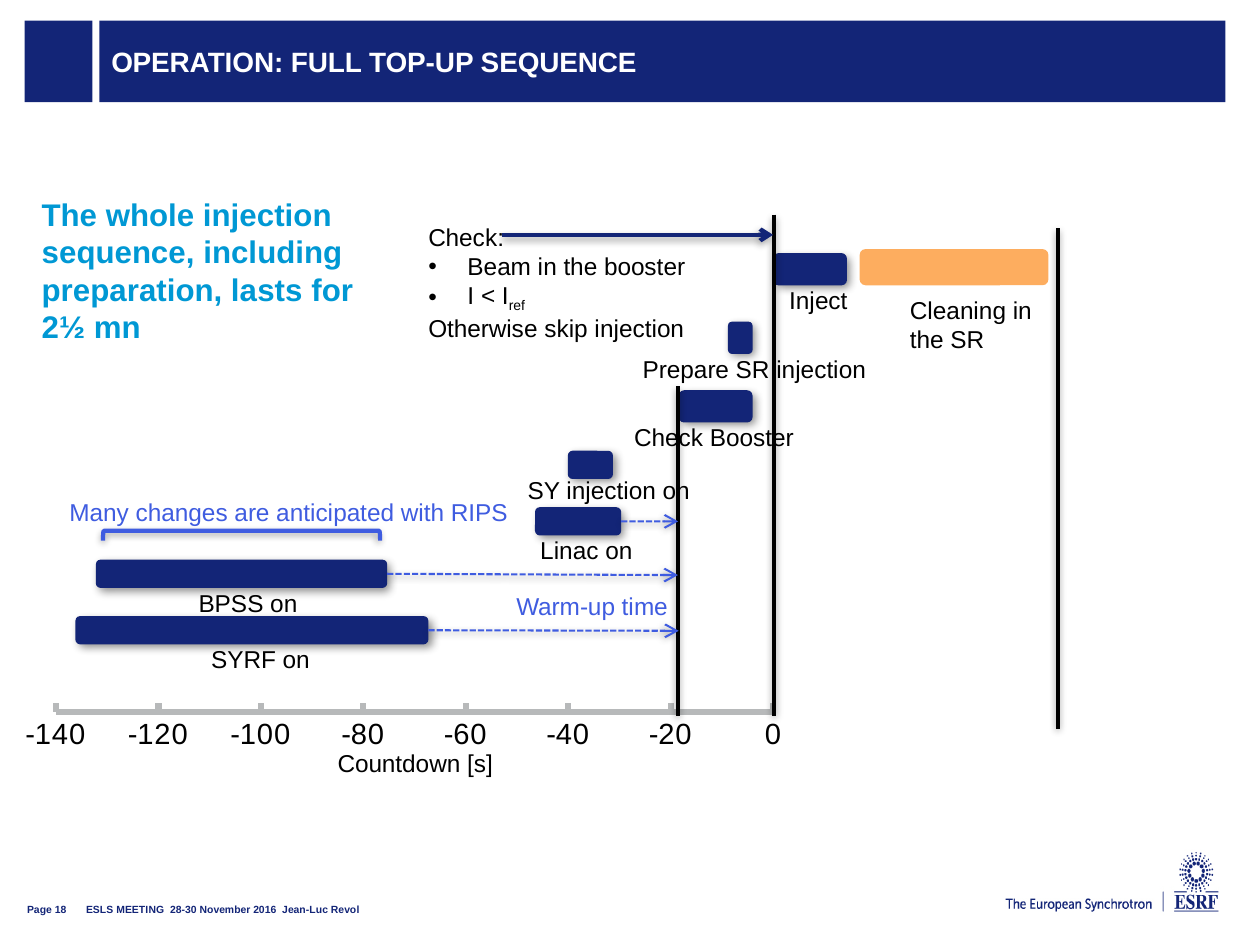
Which bar on the chart is the longest? SYRF on Which bar on the chart is the shortest? Prepare SR injection What kind of chart is shown on the slide? bar chart Which bar on the chart is coloured orange rather than dark blue? Cleaning in the SR What is the title of the x axis of the chart? Countdown [s] Is the countdown value at which the SYRF on bar starts greater or less than -120? less Which bar starts earlier on the countdown axis, BPSS on or Linac on? BPSS on Is the countdown value at which the Linac on bar starts greater or less than -60? greater Is the countdown value at which the Check Booster bar ends greater or less than 0? less What is the lowest countdown value labelled on the x axis? -140 How many labelled bars are plotted on the timeline chart? 8 Which bar on the chart begins at countdown 0? Inject